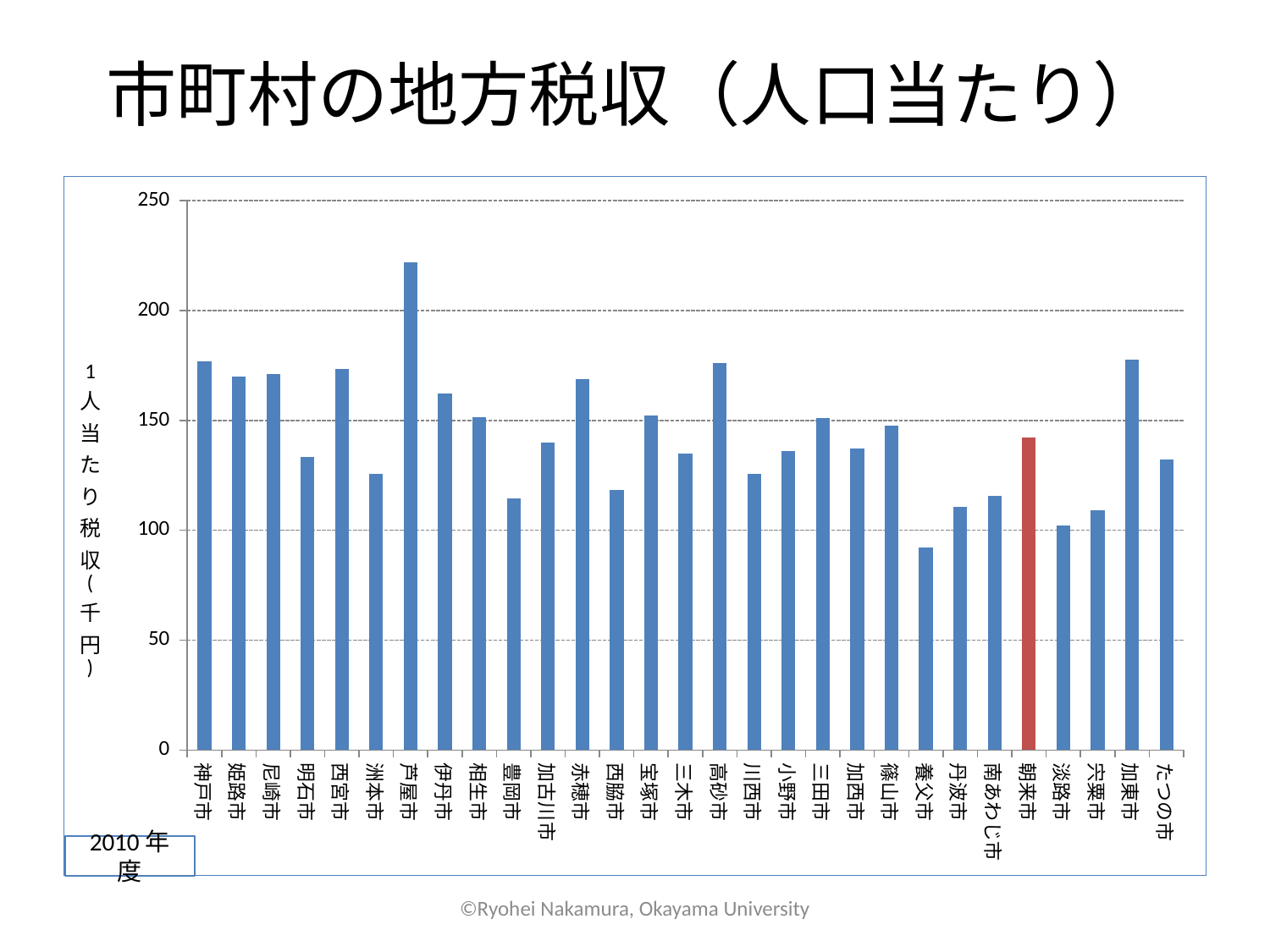
Is the value for 神戸市 greater or less than 150? greater Which municipality's bar is highlighted in red? 朝来市 Which municipality has the highest per-capita tax revenue in the chart? 芦屋市 Is the value for 洲本市 greater or less than 150? less Which has a larger value, 明石市 or 西宮市? 西宮市 What kind of chart is shown on the slide? bar chart How many municipalities are shown on the x axis of the chart? 29 Is the value for 養父市 greater or less than 100? less Which has a larger value, 芦屋市 or 神戸市? 芦屋市 Which municipality has the lowest per-capita tax revenue in the chart? 養父市